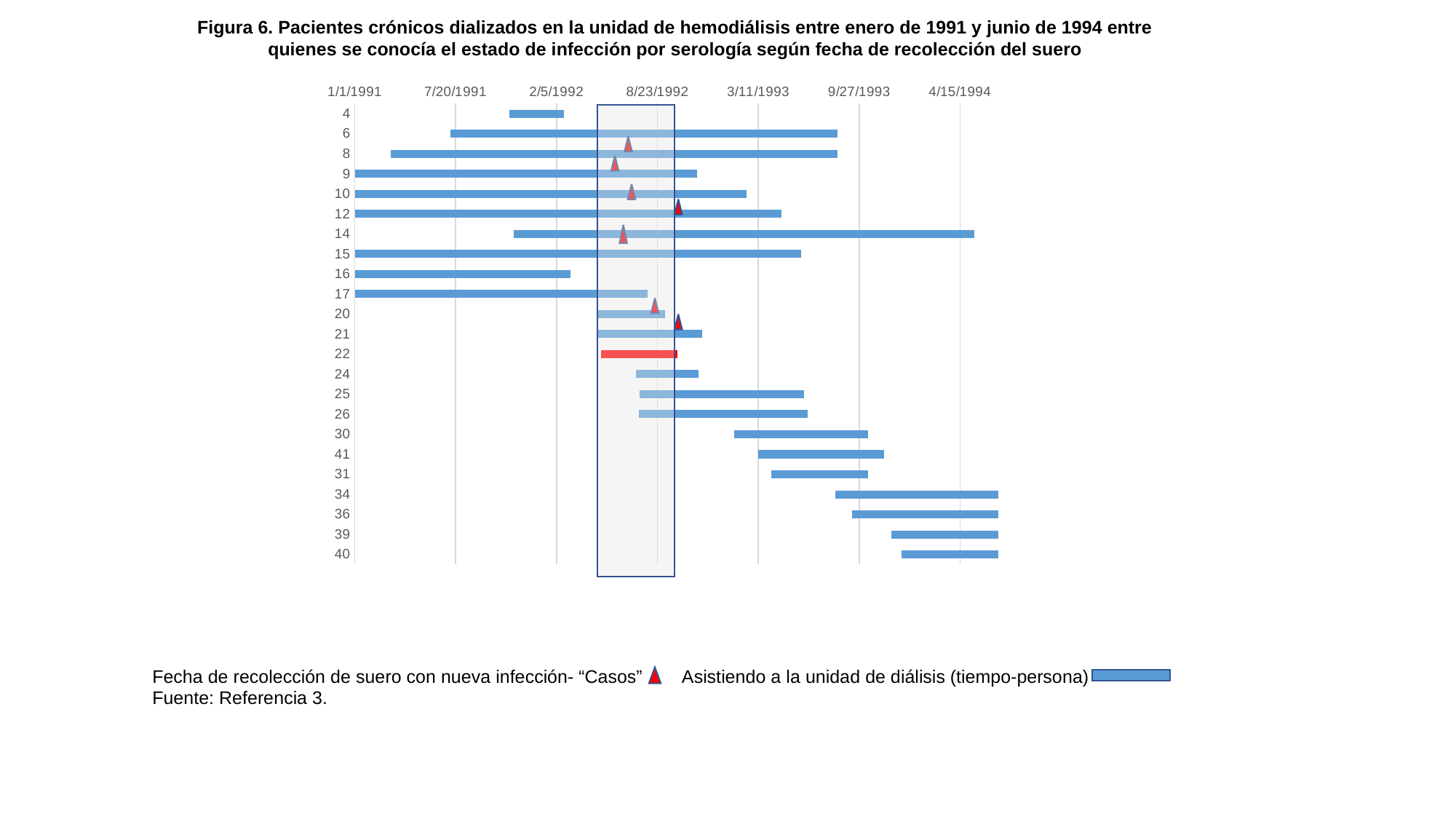
Which bar ends later, the one for patient 6 or the one for patient 9? Patient 6 Does the bar for patient 14 end before or after 9/27/1993? after Which bar starts earlier, the one for patient 4 or the one for patient 8? Patient 8 Does the bar for patient 30 start before or after 8/23/1992? after How many entries does the legend below the chart list? 2 What kind of chart is shown on the slide? Bar chart How many date ticks are shown along the horizontal axis of the chart? 7 Does the bar for patient 16 end before or after 8/23/1992? before Which patient row is drawn with a red bar instead of a blue bar? 22 How many patient rows (categories) are listed on the vertical axis of the chart? 23 What is the first date label on the horizontal axis? 1/1/1991 What is the last date label on the horizontal axis? 4/15/1994